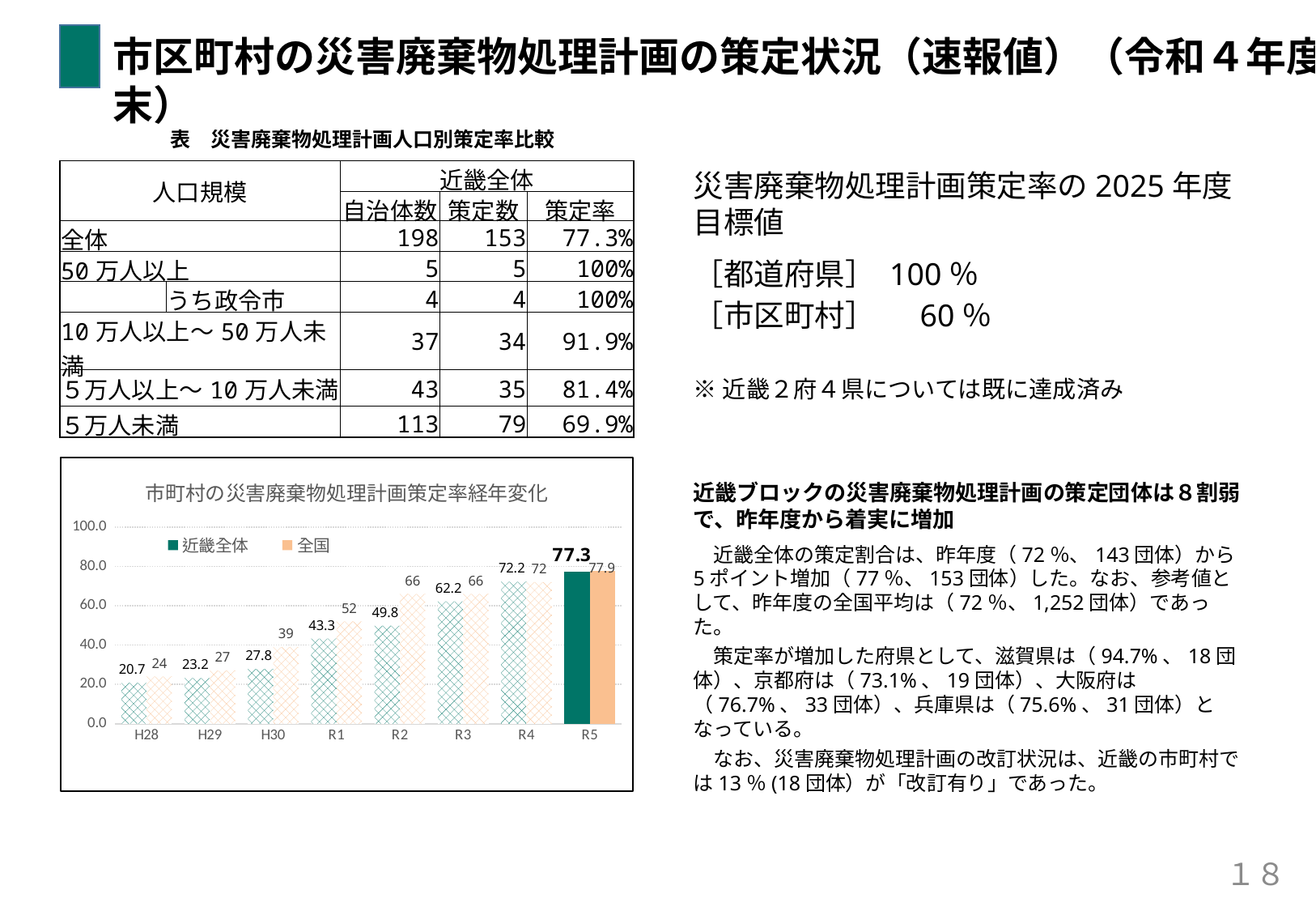
In which year does 近畿全体 have its lowest value in the chart? H28 What is the difference between the 近畿全体 values at R4 and R3 in the chart? 10 What is the value for 全国 at R5 in the chart? 77.9 Do the 近畿全体 values rise or fall from H28 to R5 in the chart? rise How many years are shown on the x axis of the chart? 8 What kind of chart is 市町村の災害廃棄物処理計画策定率経年変化? bar chart Which is larger at R2 in the chart: 近畿全体 or 全国? 全国 In which year does 全国 have its highest value in the chart? R5 What is the value for 全国 at H30 in the chart? 39 What is the value for 近畿全体 at R1 in the chart? 43.3 How many series does the legend of the chart list? 2 What is the value for 近畿全体 at R5 in the chart 市町村の災害廃棄物処理計画策定率経年変化? 77.3